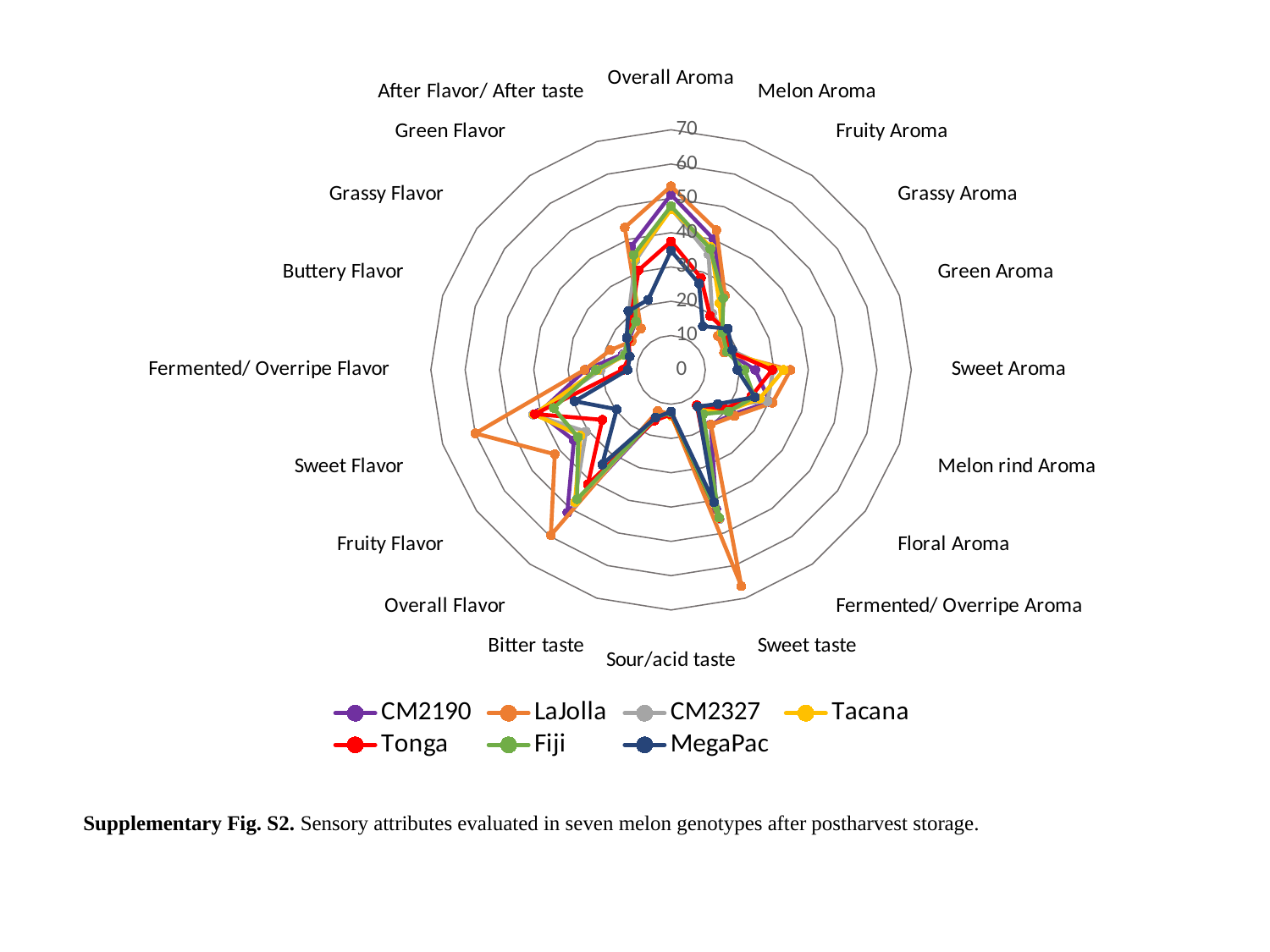
What is the highest value shown on the radial axis? 70 Which genotype has the highest value for Sweet Flavor? LaJolla Is the value for LaJolla on Sweet Flavor greater or less than 50? greater Is the value for LaJolla on Sweet taste greater or less than 50? greater How many sensory attributes (categories) are plotted around the radar chart? 20 Which is larger for Sweet Flavor, LaJolla or MegaPac? LaJolla Which genotype has the lowest value for Overall Aroma? MegaPac Which genotype has the highest value for Sweet taste? LaJolla What kind of chart is shown on the slide? Radar chart What colour is the LaJolla series drawn in? Orange How many series does the legend list? 7 Is the value for MegaPac on Overall Aroma greater or less than 30? greater